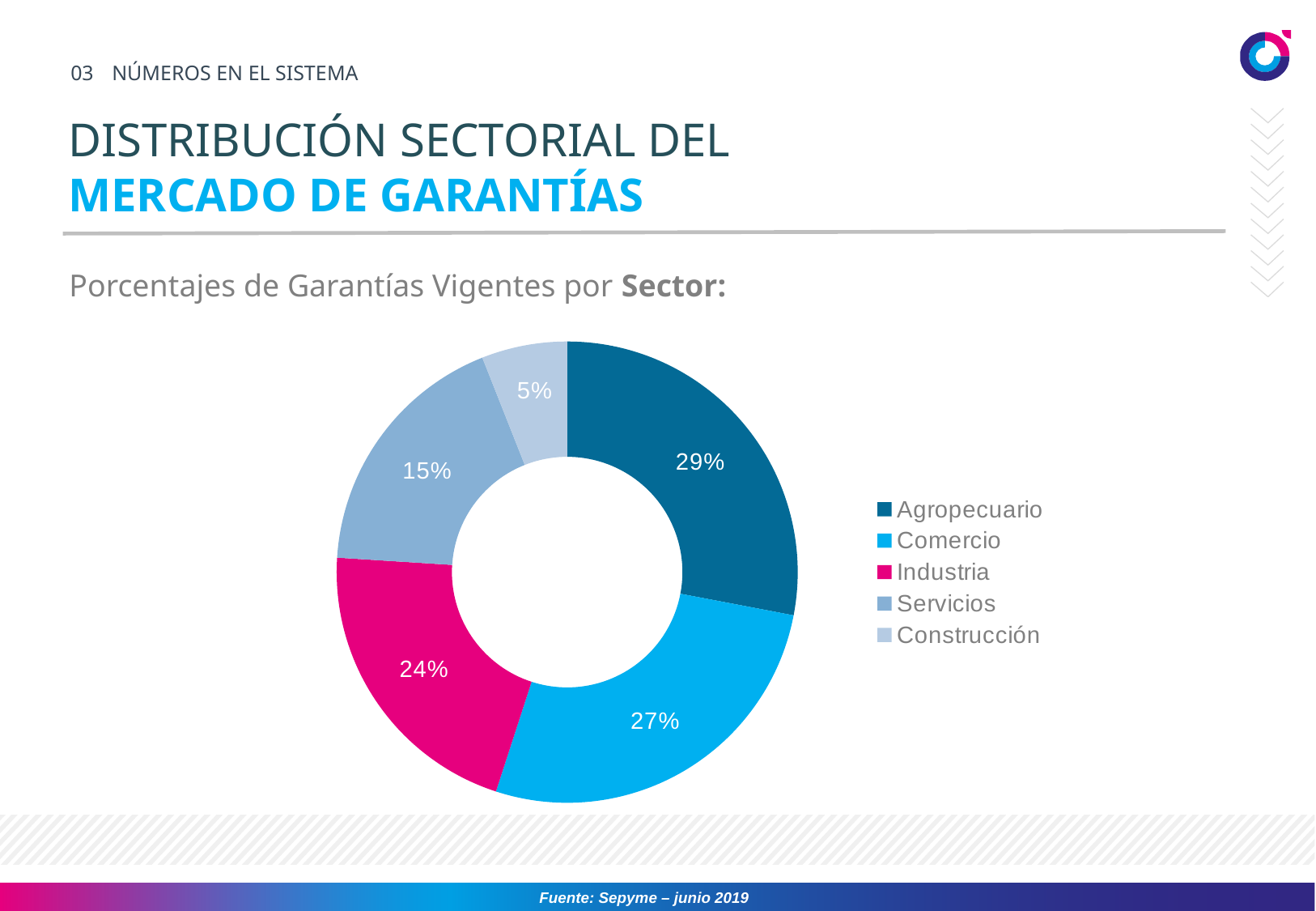
What is the difference in percentage points between Agropecuario and Construcción? 24 What share does Industria have in the chart? 24% What is the value shown for Comercio? 27% What percentage of the pie chart does Agropecuario represent? 29% How many sectors are shown in the chart? 5 What is the value for Construcción? 5% Which sector has the smallest share of the chart? Construcción Which sector is shown in magenta/pink in the chart? Industria Which sector has the largest share of the chart? Agropecuario What percentage is shown for Servicios? 15% Which is larger, the share for Industria or the share for Servicios? Industria What type of chart is shown on the slide? Pie chart (doughnut)